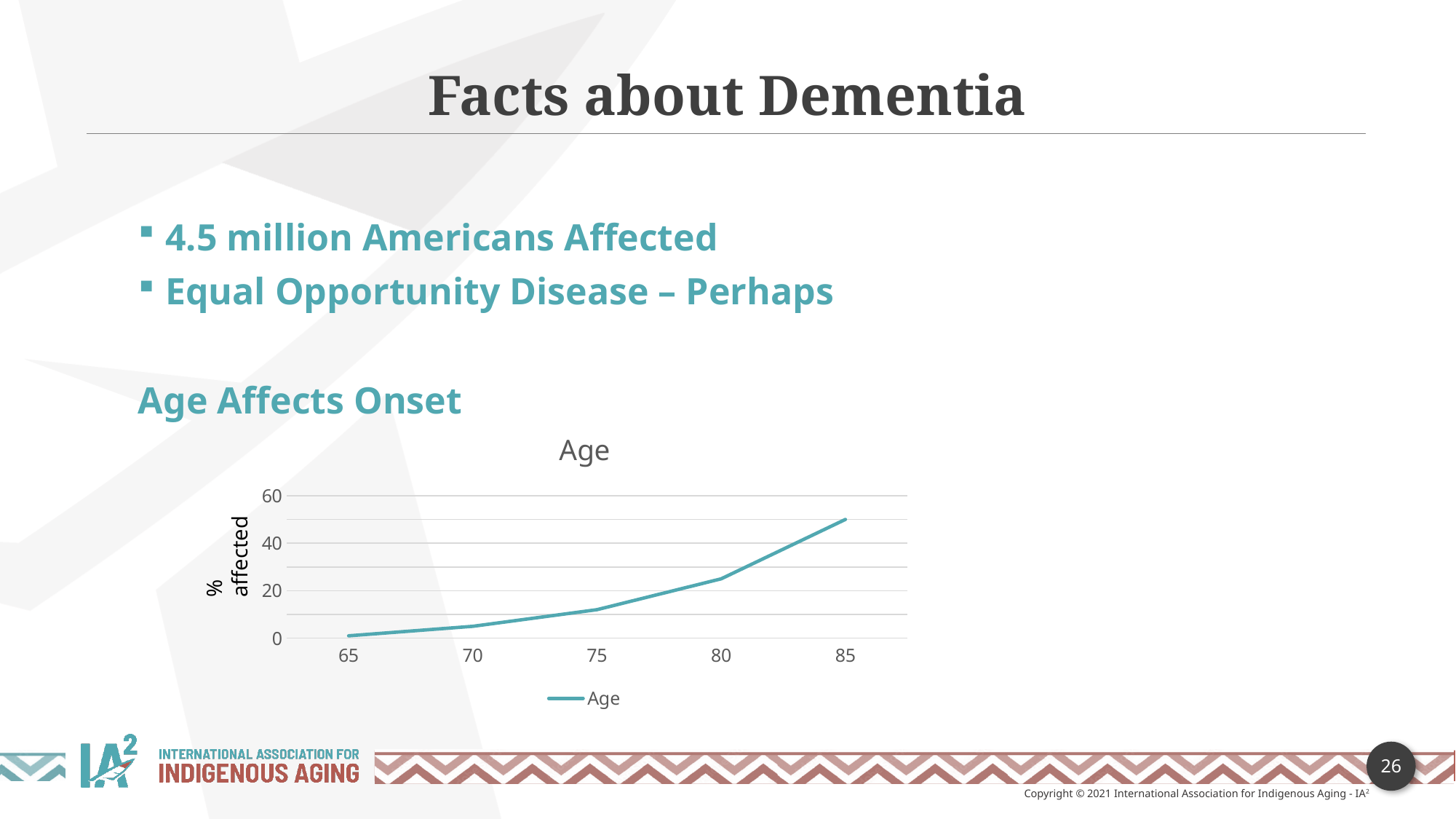
Which has a larger % affected, age 80 or age 85? 85 What is the label on the vertical axis of the chart? % affected Is the value for age 65 greater or less than 20? less What is the title of the chart? Age Do the values rise or fall as age increases along the x axis? rise Which age has the lowest % affected in the chart? 65 How many series does the chart's legend list? 1 Is the value for age 85 greater or less than 40? greater Is the value for age 75 greater or less than 20? less What kind of chart is shown on the slide? line chart Which age has the highest % affected in the chart? 85 How many age points are plotted along the x axis of the chart? 5